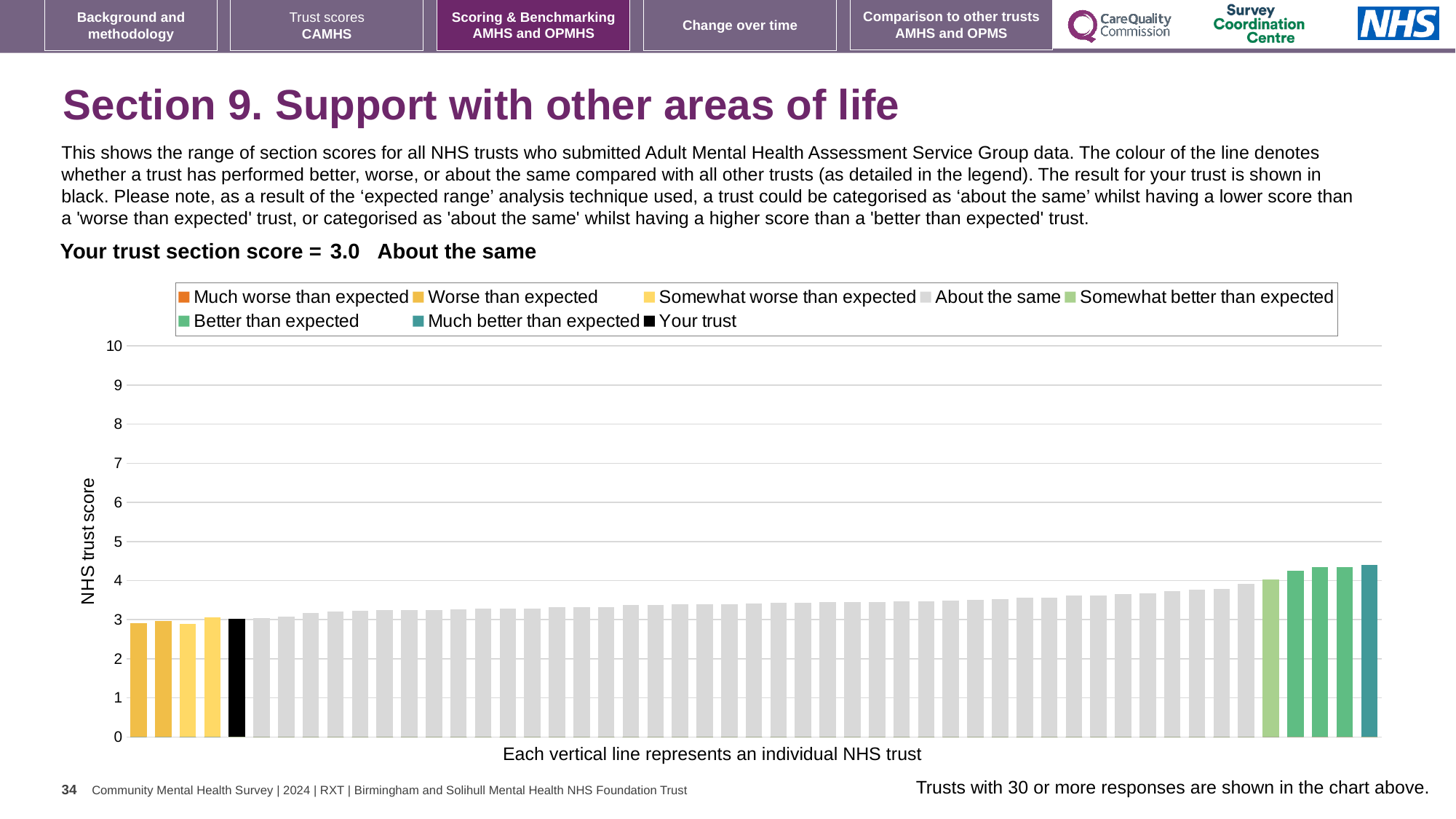
What is the label on the vertical axis of the chart? NHS trust score How many bars are coloured as 'Better than expected'? 3 Is the value of the tallest bar in the chart greater or less than 4? greater How many bars are coloured as 'Much better than expected'? 1 What kind of chart is shown on the slide? bar chart What colour is the bar representing your trust? black Is the value for your trust greater or less than 5? less Do the bar values rise or fall from left to right along the x axis? rise How many entries does the chart legend list? 8 What is the section score for your trust shown on the slide? 3.0 Is the bar for your trust higher or lower than the rightmost bar in the chart? lower Which performance category is your trust placed in for this section? About the same